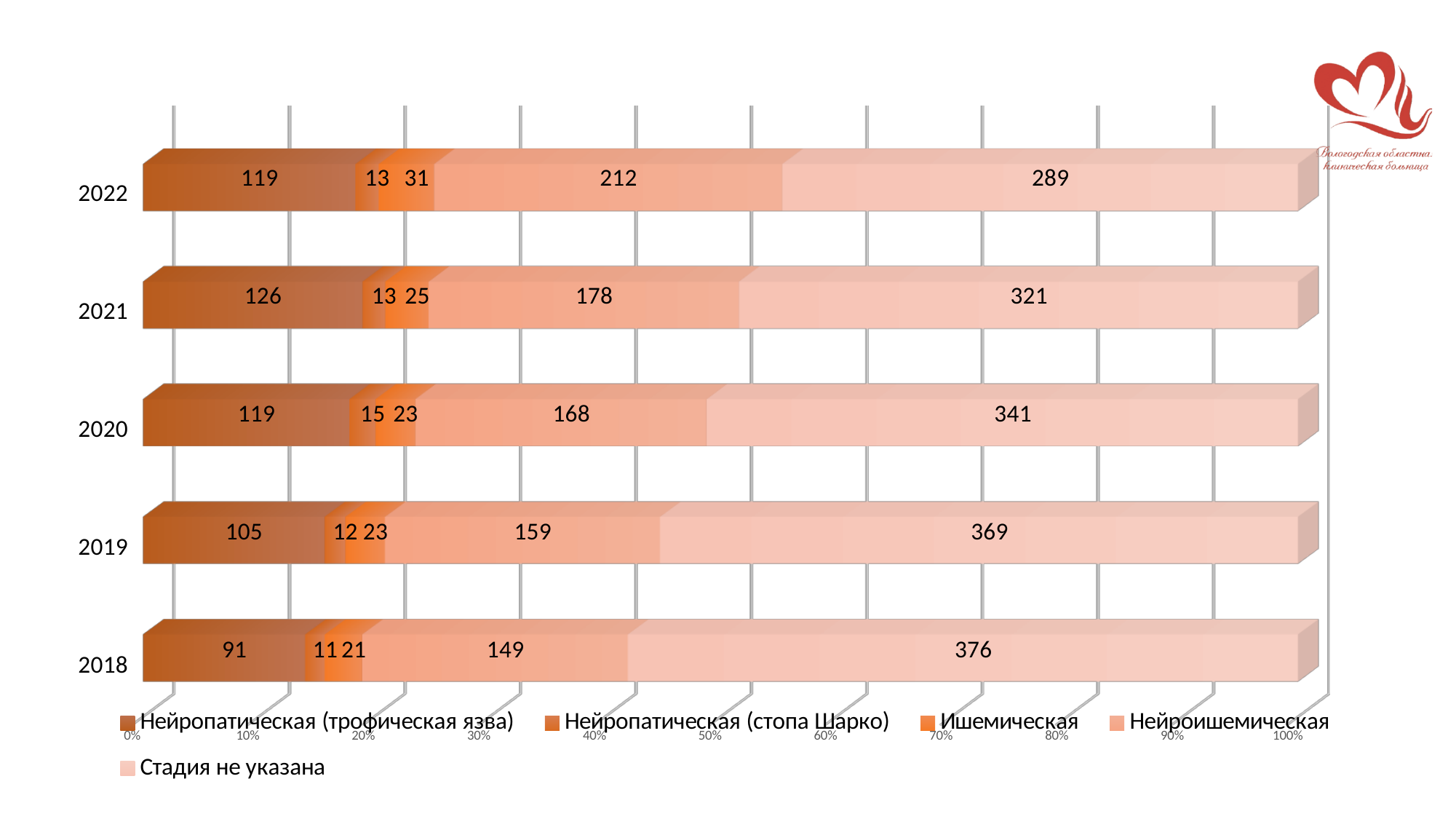
In which year is the value for Стадия не указана the lowest? 2022 What is the value for Нейропатическая (трофическая язва) in 2021? 126 What is the value for Ишемическая in 2022? 31 What is the total of the stacked bar for 2018? 648 How many years (categories) are shown on the chart? 5 Which is larger: the Нейропатическая (стопа Шарко) value in 2020 or in 2019? 2020 In which year is the value for Нейроишемическая the highest? 2022 What is the value for Стадия не указана in 2018? 376 What kind of chart is shown on the slide? stacked bar chart What is the difference between the Стадия не указана values for 2018 and 2022? 87 What is the value for Нейроишемическая in 2020? 168 How many series does the legend list? 5